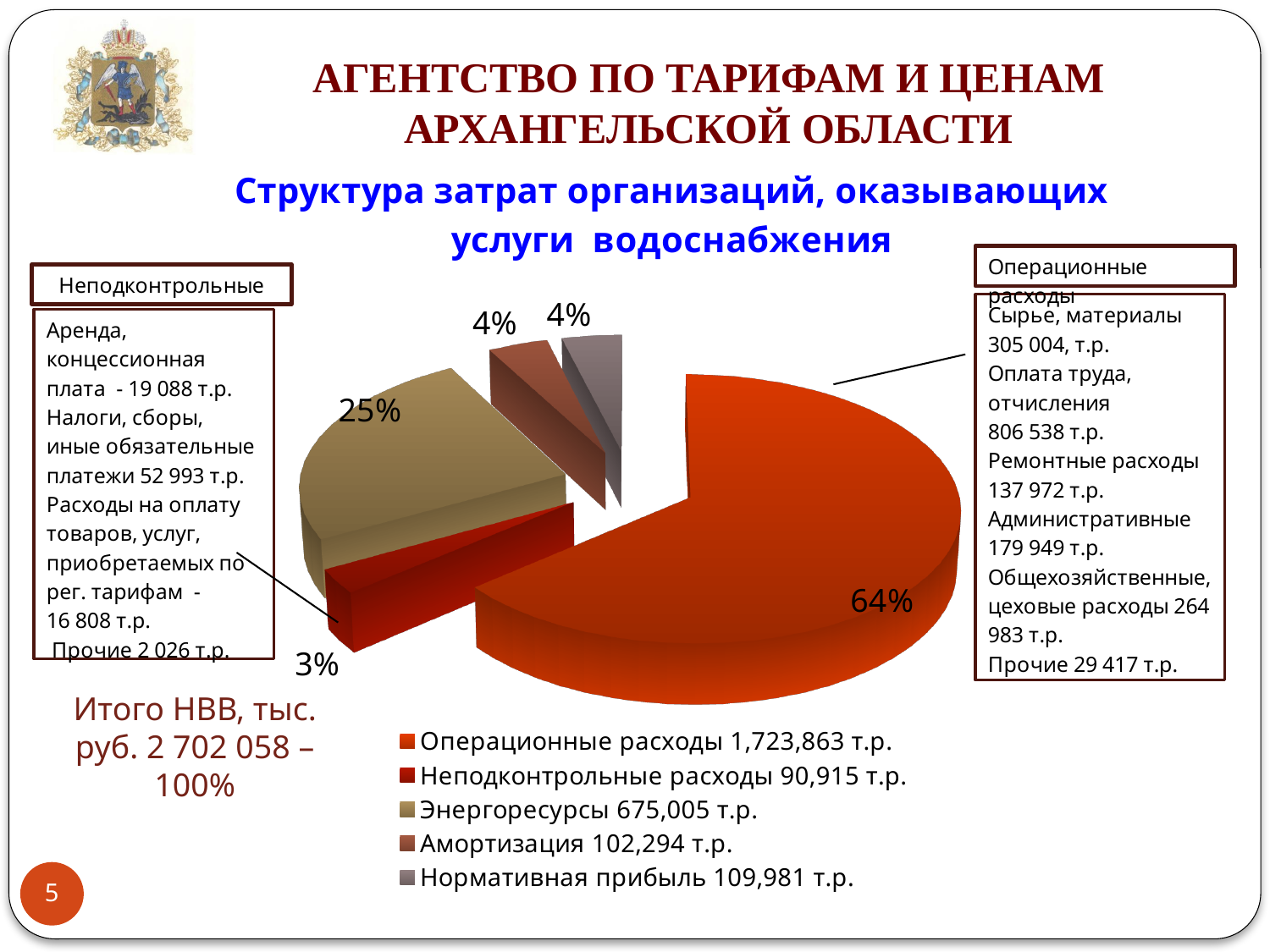
How many slices does the pie chart have? 5 What type of chart is shown on the slide? pie chart Which category has the largest slice of the pie? Операционные расходы Which is larger, the share for Энергоресурсы or the share for Амортизация? Энергоресурсы How many entries does the legend of the pie chart list? 5 What share of the pie does Операционные расходы take? 64% According to the legend, what is the value for Энергоресурсы? 675,005 т.р. What percentage is shown for Амортизация? 4% What percentage is shown for Неподконтрольные расходы? 3% What is the difference in percentage points between the Операционные расходы slice and the Энергоресурсы slice? 39 What share of the pie does Энергоресурсы take? 25% Which category has the smallest slice of the pie? Неподконтрольные расходы